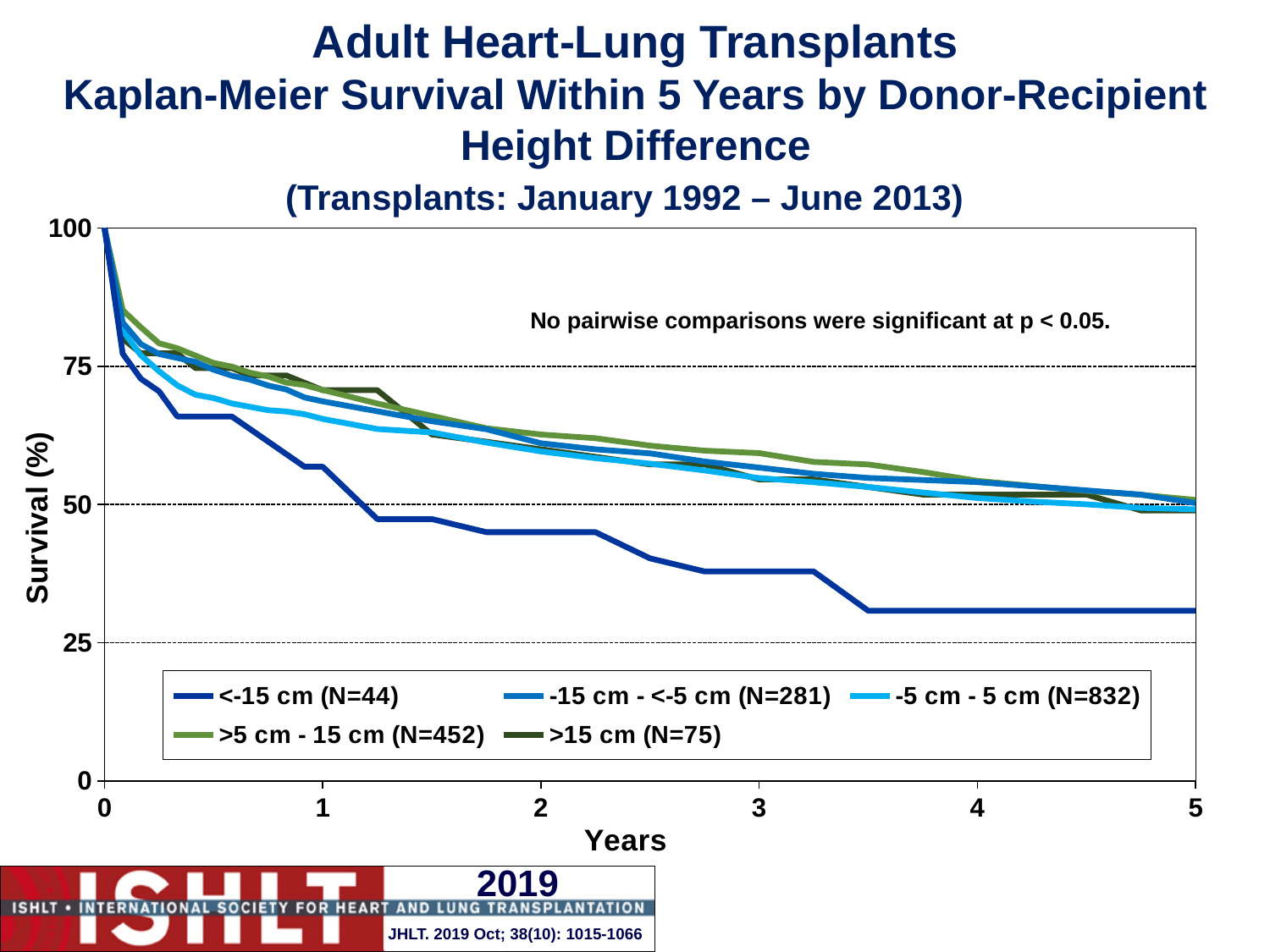
How many series does the legend list? 5 How many patients (N) are in the -5 cm - 5 cm group according to the legend? 832 Is the survival for the -5 cm - 5 cm group at 1 year greater or less than 75? less Is the survival for the <-15 cm group at 4 years greater or less than 50? less At 3 years, which group has higher survival: <-15 cm or >5 cm - 15 cm? >5 cm - 15 cm Which height-difference group has the lowest survival at 5 years? <-15 cm (N=44) What kind of chart is shown on the slide? line chart Is the survival for the <-15 cm group at 1 year greater or less than 50? greater What is the survival value for all groups at year 0? 100 What is the label of the y axis? Survival (%) Do the survival curves rise or fall as years increase? fall